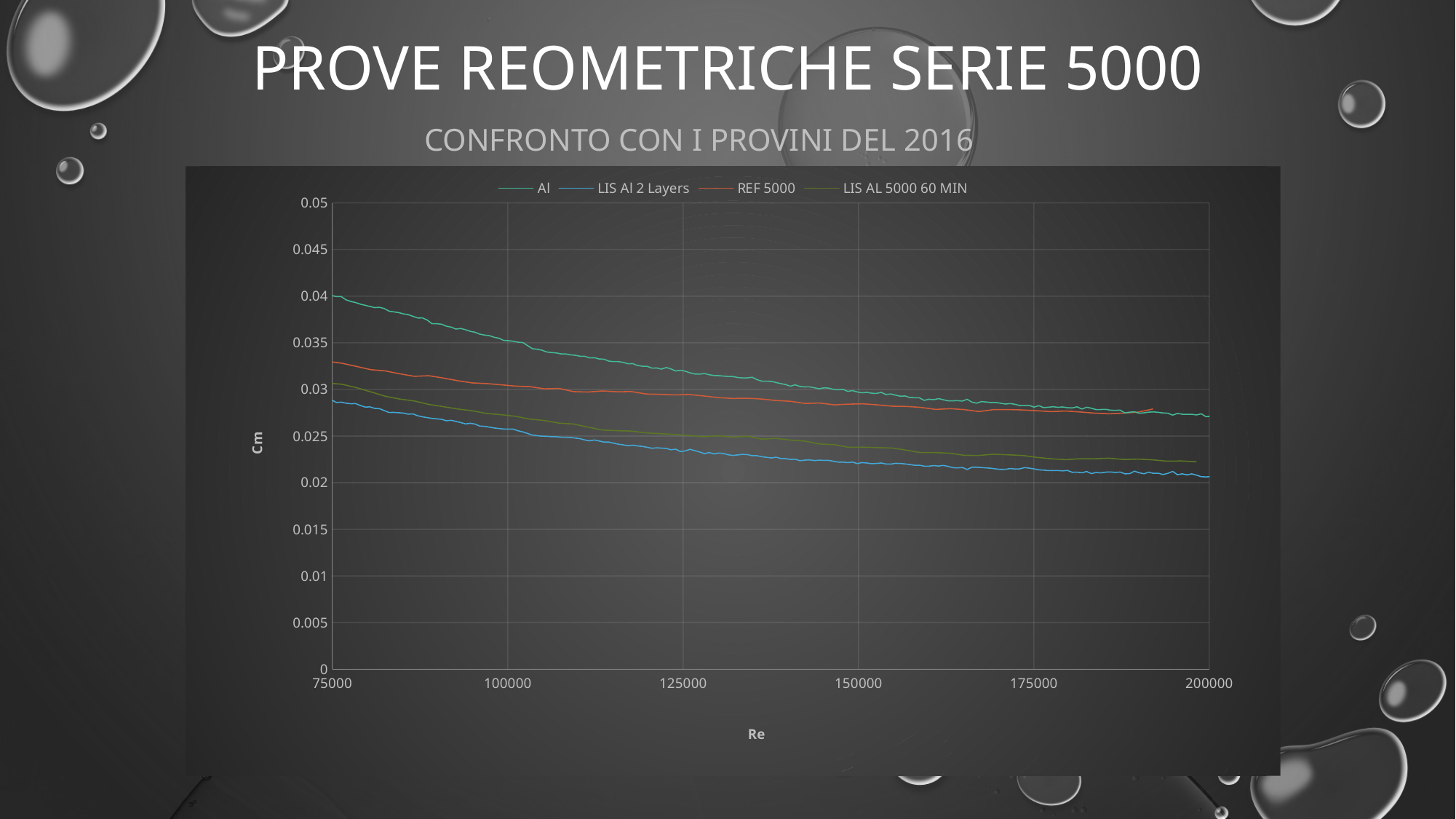
Is the Cm value for the LIS Al 2 Layers series at Re = 200000 greater or less than 0.025? less Does the Cm value of the Al series rise or fall as Re increases? fall Is the Cm value for the REF 5000 series at Re = 75000 greater or less than 0.03? greater Which series has the highest Cm value at Re = 75000? Al How many series does the legend list? 4 Which series has the lowest Cm value at Re = 200000? LIS Al 2 Layers Does the Cm value of the LIS AL 5000 60 MIN series rise or fall as Re increases? fall At Re = 100000, which series has the larger Cm value: Al or LIS Al 2 Layers? Al Is the Cm value for the Al series at Re = 75000 greater or less than 0.035? greater What is the label of the x axis of the chart? Re At Re = 150000, which series has the larger Cm value: REF 5000 or LIS AL 5000 60 MIN? REF 5000 What kind of chart is shown on the slide? line chart